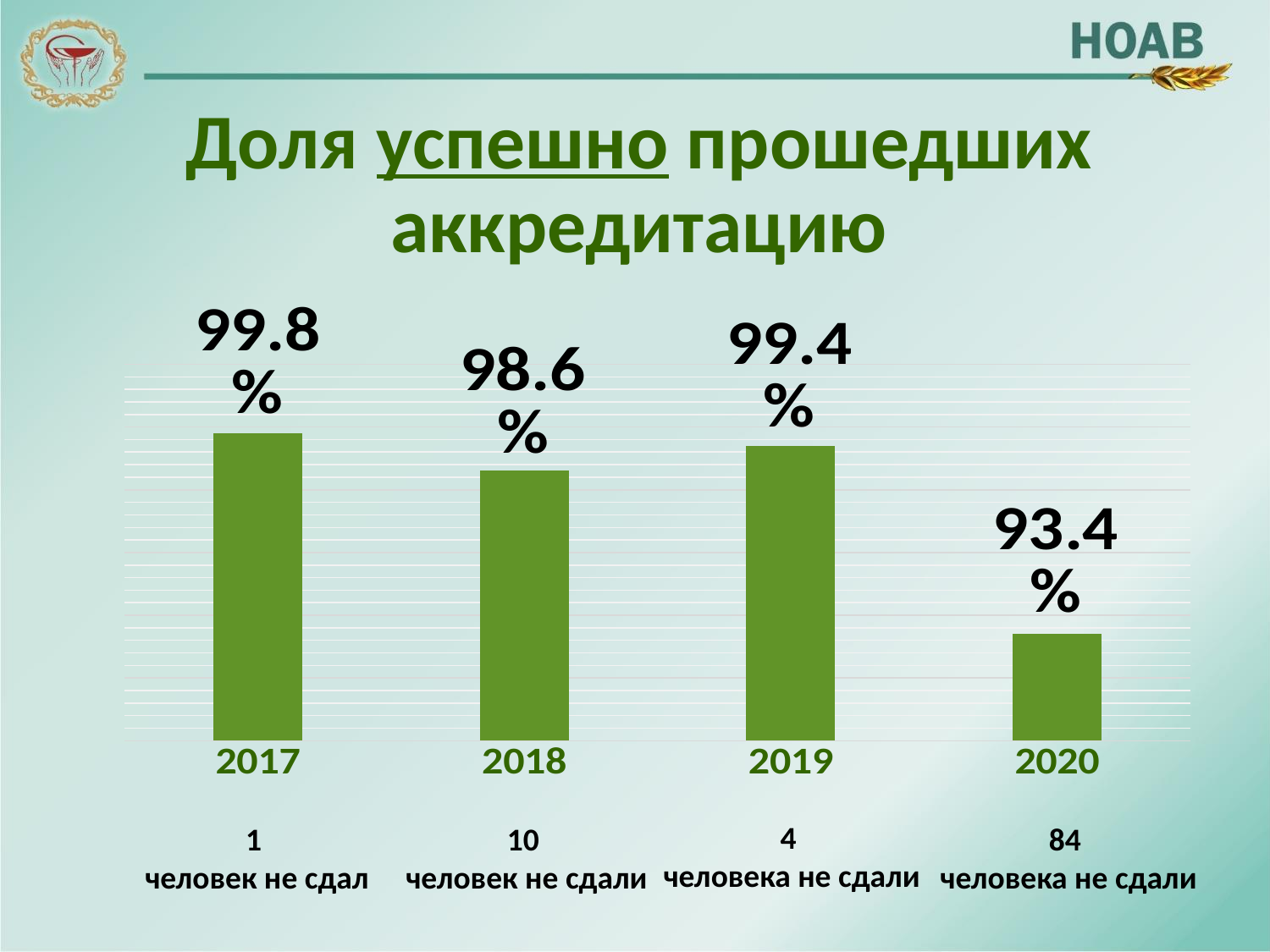
Which year has the highest share of successfully accredited? 2017 Which year has the lowest share of successfully accredited? 2020 What is the title of the chart on the slide? Доля успешно прошедших аккредитацию What is the value for 2019? 99.4% How many years are shown in the chart? 4 Which is larger, the value for 2018 or the value for 2019? 2019 What is the value for 2017? 99.8% What is the value for 2020? 93.4% What kind of chart is shown on the slide? bar chart What is the difference between the values for 2017 and 2020? 6.4% What is the value for 2018? 98.6% What is the difference between the values for 2019 and 2018? 0.8%